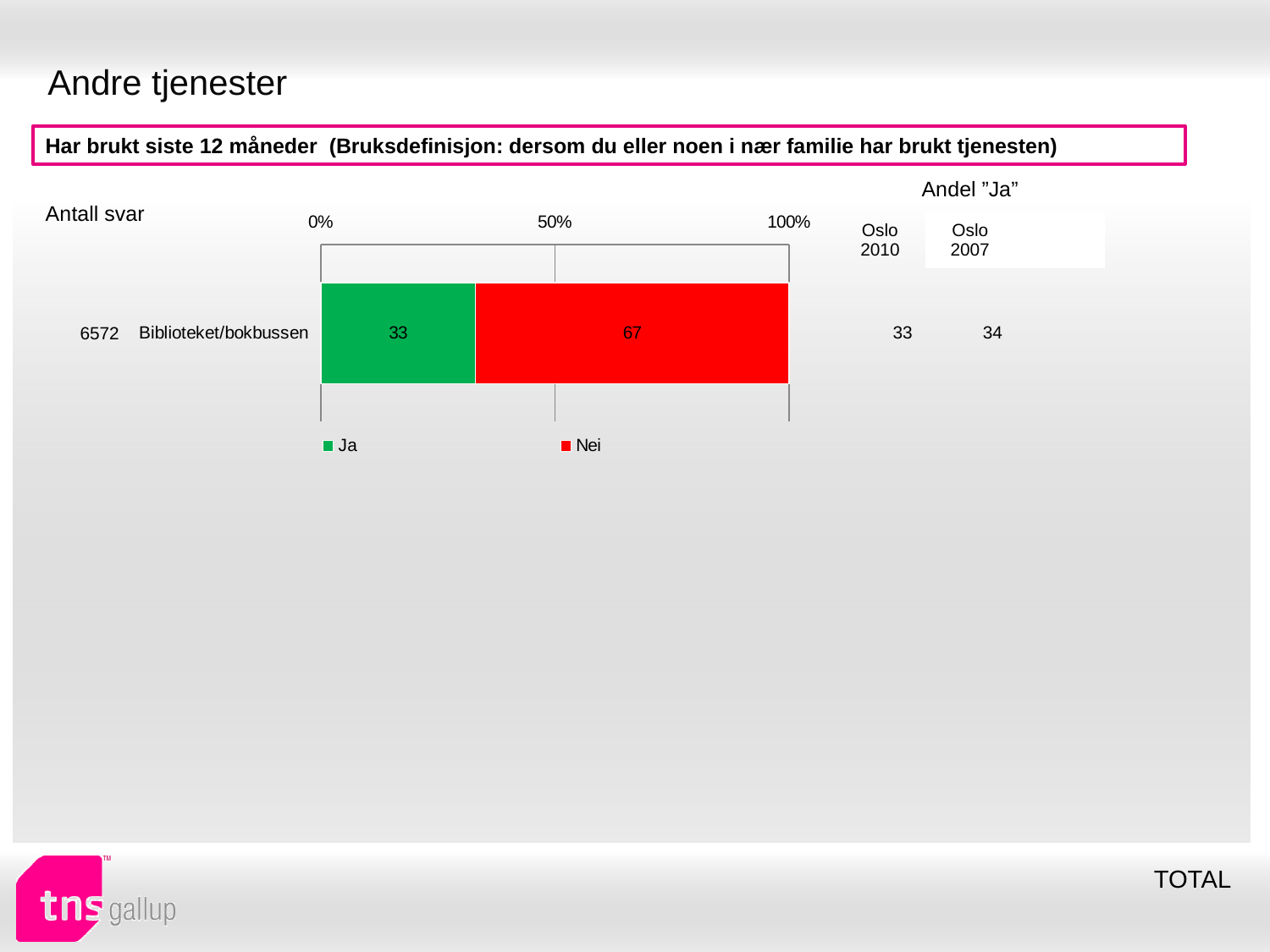
What is the value for "Ja" for Biblioteket/bokbussen? 33 What is the value for "Nei" for Biblioteket/bokbussen? 67 Is the value for Nei for Biblioteket/bokbussen greater or less than 50%? greater What kind of chart is shown on the slide? Stacked bar chart What is the number of responses (Antall svar) shown for Biblioteket/bokbussen? 6572 Which series has the larger value for Biblioteket/bokbussen, Ja or Nei? Nei How many categories are plotted in the chart? 1 Is the value for Ja for Biblioteket/bokbussen greater or less than 50%? less What is the difference between the Nei and Ja values for Biblioteket/bokbussen? 34 What is the total of the stacked bar for Biblioteket/bokbussen? 100 What colour represents the "Ja" series in the chart? Green How many series does the legend list? 2